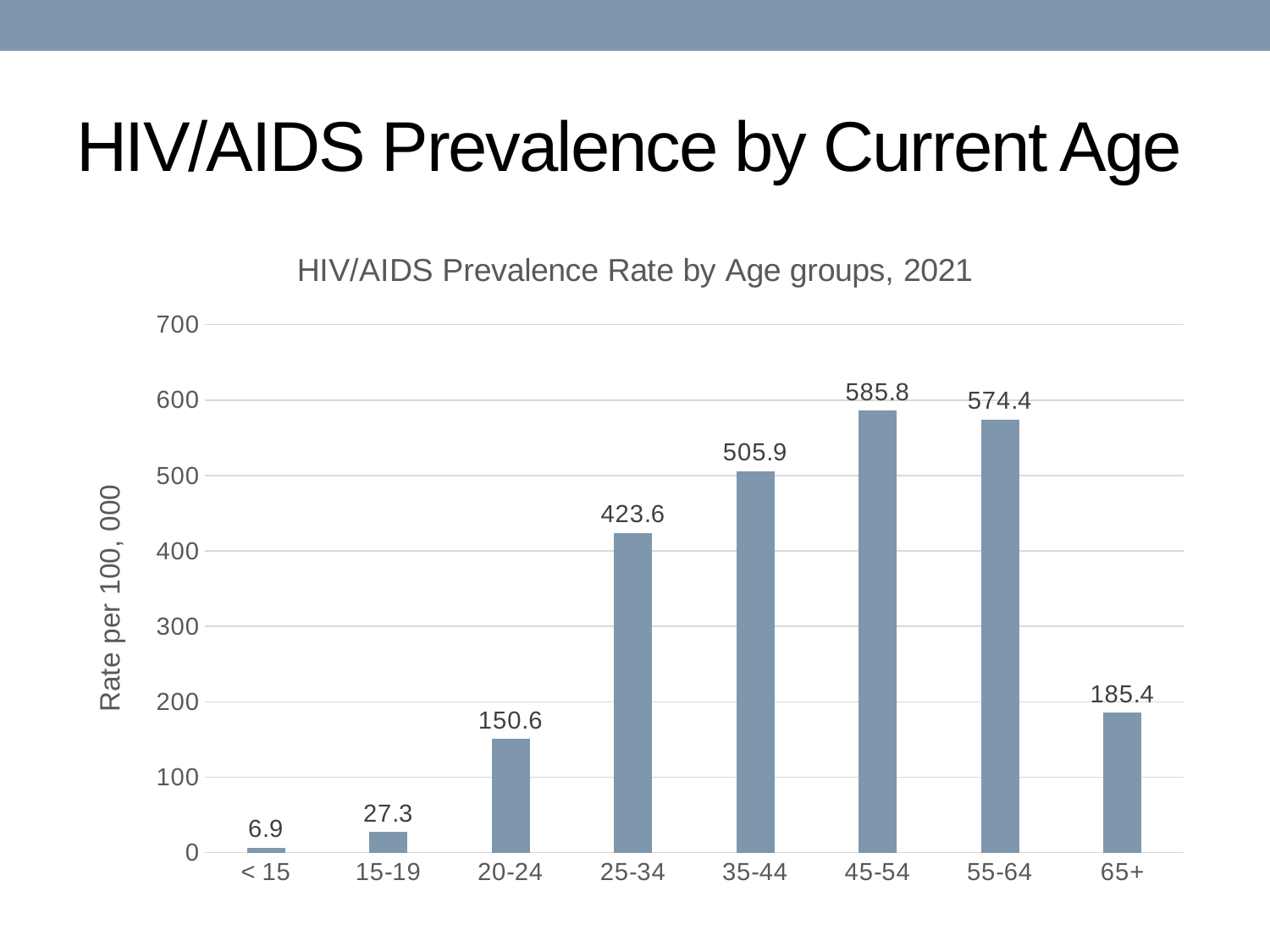
Is the prevalence rate for the 35-44 age group greater or less than 500? greater What is the HIV/AIDS prevalence rate for the 25-34 age group? 423.6 What is the label of the vertical axis of the chart? Rate per 100, 000 What is the difference between the prevalence rates for the 20-24 and 15-19 age groups? 123.3 Which age group has the lowest HIV/AIDS prevalence rate? < 15 How many age groups are shown in the chart? 8 Which age group has a higher prevalence rate, 35-44 or 65+? 35-44 What is the HIV/AIDS prevalence rate for the < 15 age group? 6.9 What type of chart is shown on the slide? Bar chart What is the HIV/AIDS prevalence rate for the 65+ age group? 185.4 What is the difference between the prevalence rates for the 45-54 and 55-64 age groups? 11.4 Which age group has the highest HIV/AIDS prevalence rate? 45-54